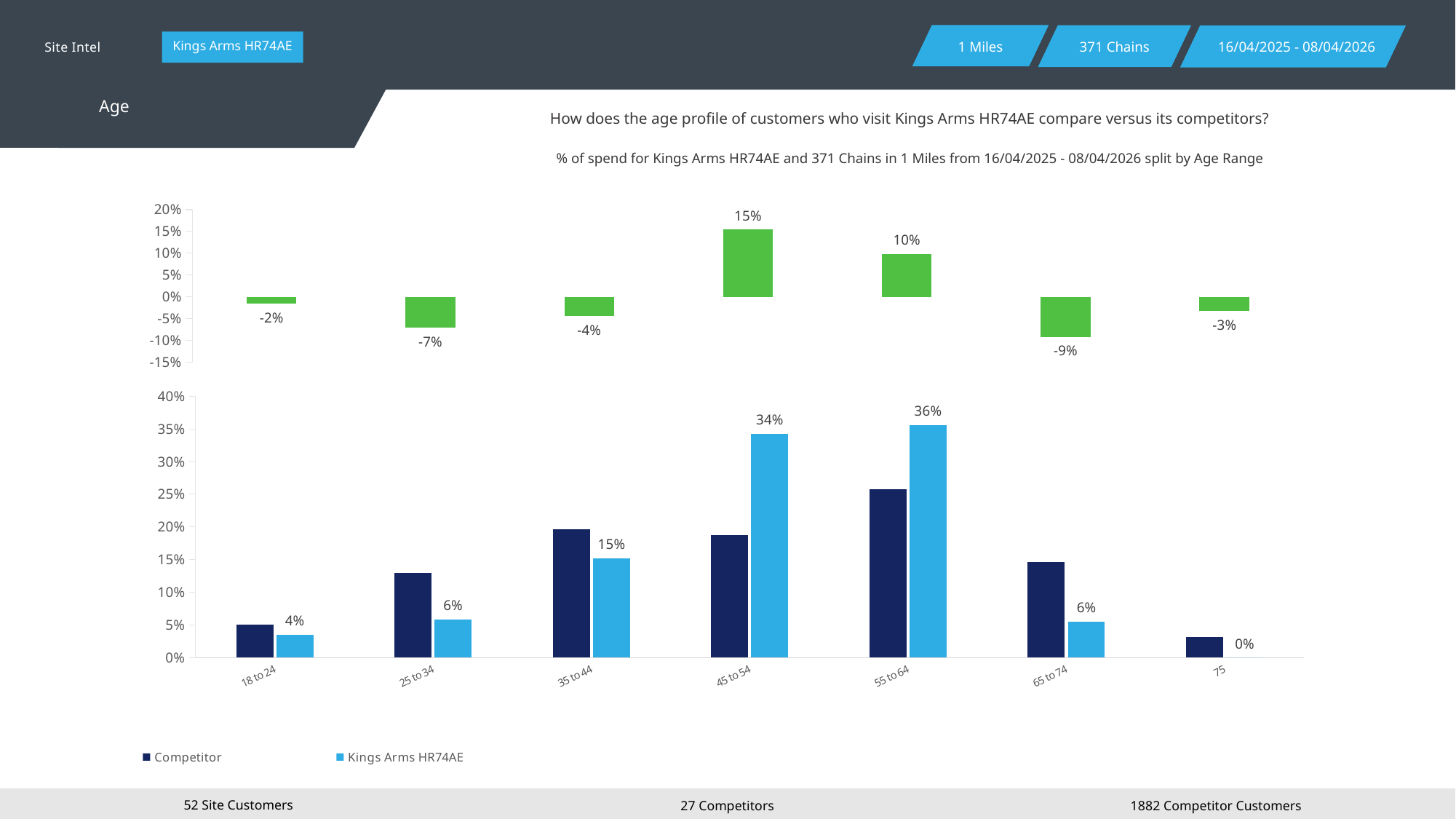
In the bottom chart, which age range has the highest Kings Arms HR74AE value? 55 to 64 In the top chart, what is the value for the 45 to 54 age range? 15% How many series does the legend of the bottom chart list? 2 In the top chart, which age range has the lowest value? 65 to 74 In the top chart, which age range has the highest value? 45 to 54 In the bottom chart, which is larger for the 35 to 44 age range, the Competitor bar or the Kings Arms HR74AE bar? Competitor In the bottom chart, what is the Kings Arms HR74AE value for the 55 to 64 age range? 36% In the bottom chart, is the Competitor value for 55 to 64 greater or less than 20%? greater How many age range categories are shown on the x axis of the bottom chart? 7 In the bottom chart, what is the Kings Arms HR74AE value for the 18 to 24 age range? 4% In the top chart, what is the difference between the values for 45 to 54 and 55 to 64? 5% In the top chart, what is the value for the 65 to 74 age range? -9%